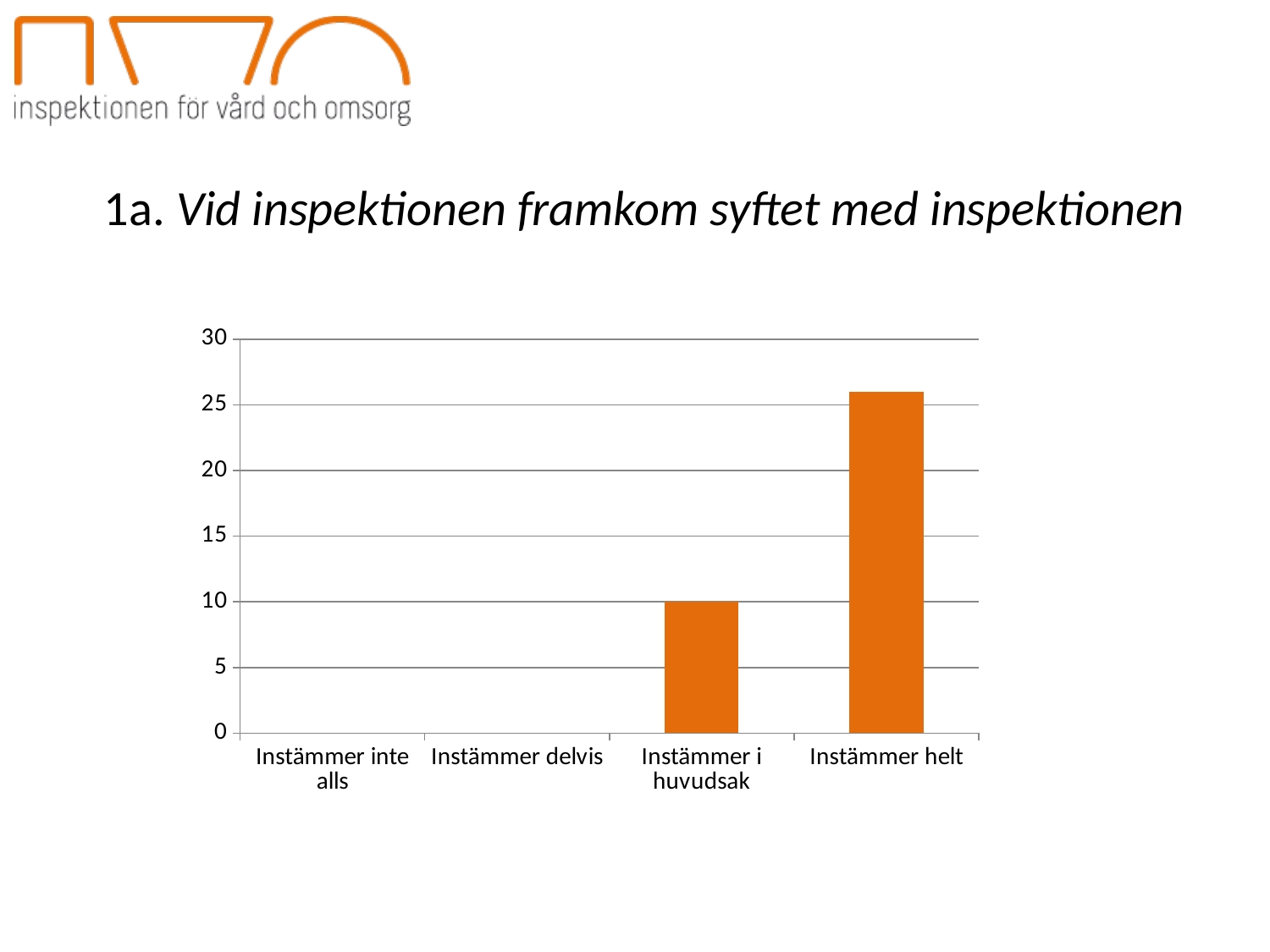
How many categories in the chart have no visible bar? 2 How many categories are shown on the x axis of the chart? 4 Which category has the highest value in the chart? Instämmer helt Is the value for Instämmer helt greater or less than 20? greater Is the value for Instämmer i huvudsak greater or less than 15? less Is the value for Instämmer helt greater or less than 30? less What colour are the bars in the chart? orange What kind of chart is shown on the slide? bar chart What is the value for Instämmer i huvudsak? 10 What is the title of the chart on the slide? 1a. Vid inspektionen framkom syftet med inspektionen Which is larger, the value for Instämmer helt or the value for Instämmer i huvudsak? Instämmer helt Do the values rise or fall moving from left to right along the x axis? rise